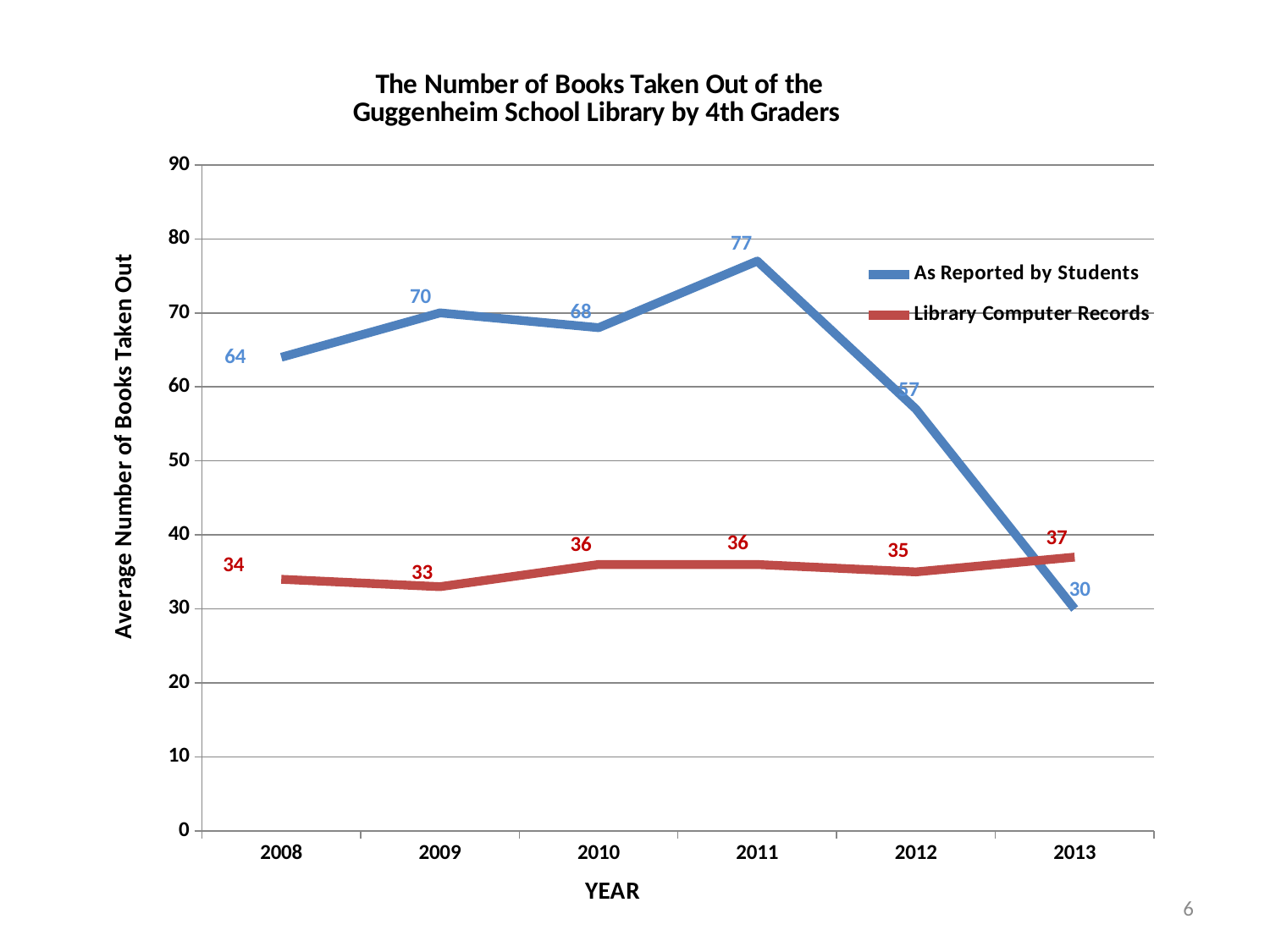
Does the As Reported by Students series rise or fall from 2011 to 2013? Fall What is the value for As Reported by Students in 2013? 30 In which year is the As Reported by Students value highest? 2011 What is the value for Library Computer Records in 2009? 33 How many series does the legend list? 2 What is the label of the y axis? Average Number of Books Taken Out What is the value for As Reported by Students in 2011? 77 Which is larger in 2013: As Reported by Students or Library Computer Records? Library Computer Records In which year is the As Reported by Students value lowest? 2013 What kind of chart is this? Line chart How many years are shown on the x axis? 6 What is the difference between the As Reported by Students value and the Library Computer Records value in 2011? 41